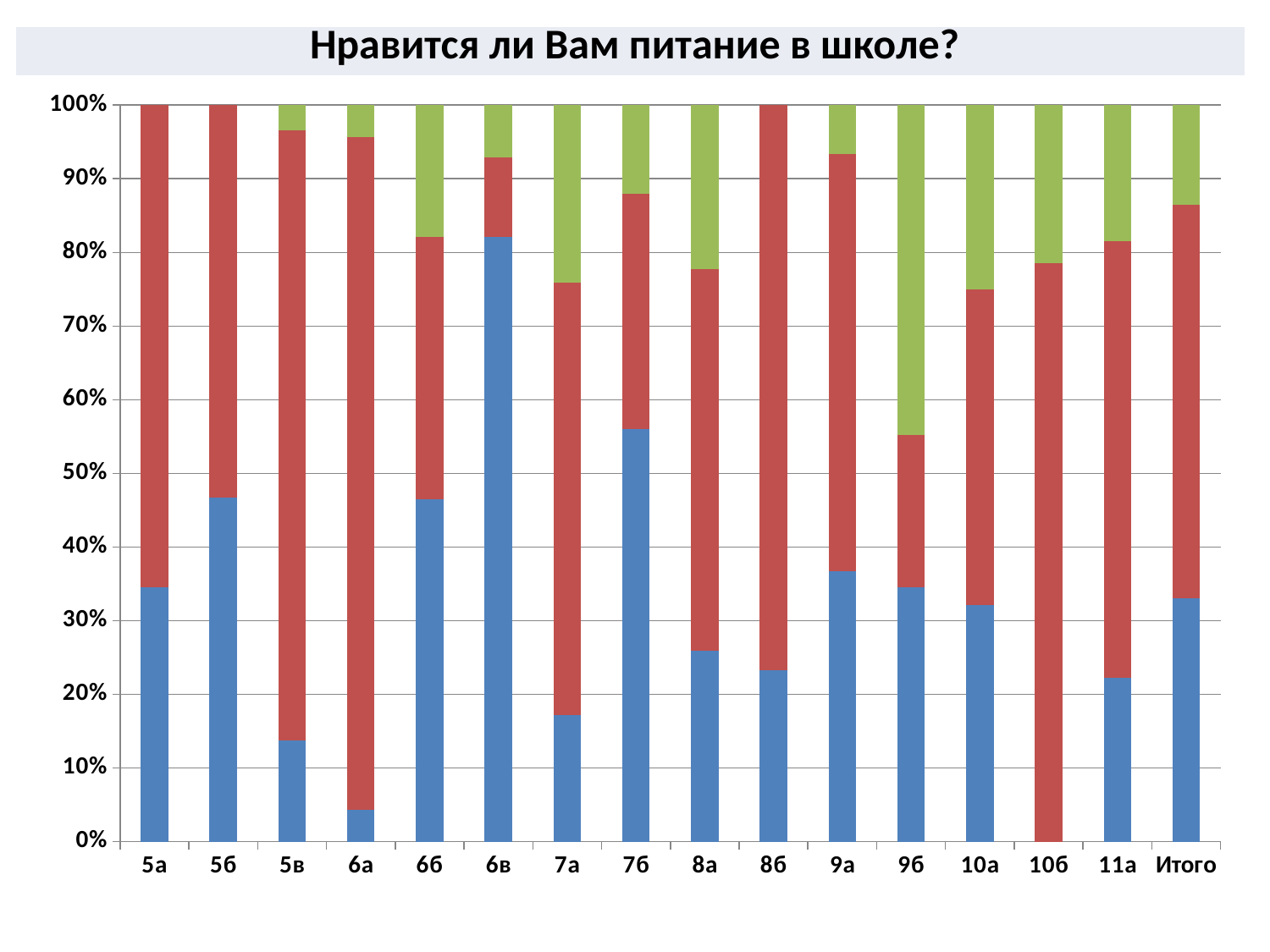
Which category has no blue segment at all? 10б Is the blue segment for 7б greater or less than 50%? greater Which category has the tallest blue segment? 6в How many categories are shown along the x axis? 16 What kind of chart is shown on the slide? Stacked bar chart Which has the larger blue segment, 6б or 5в? 6б Does the top of the red segment for 9б lie above or below 60%? below What is the title of the chart? Нравится ли Вам питание в школе? Which categories have no green segment? 5а, 5б, 8б Is the blue segment for 6а greater or less than 10%? less Which category has the largest green segment? 9б